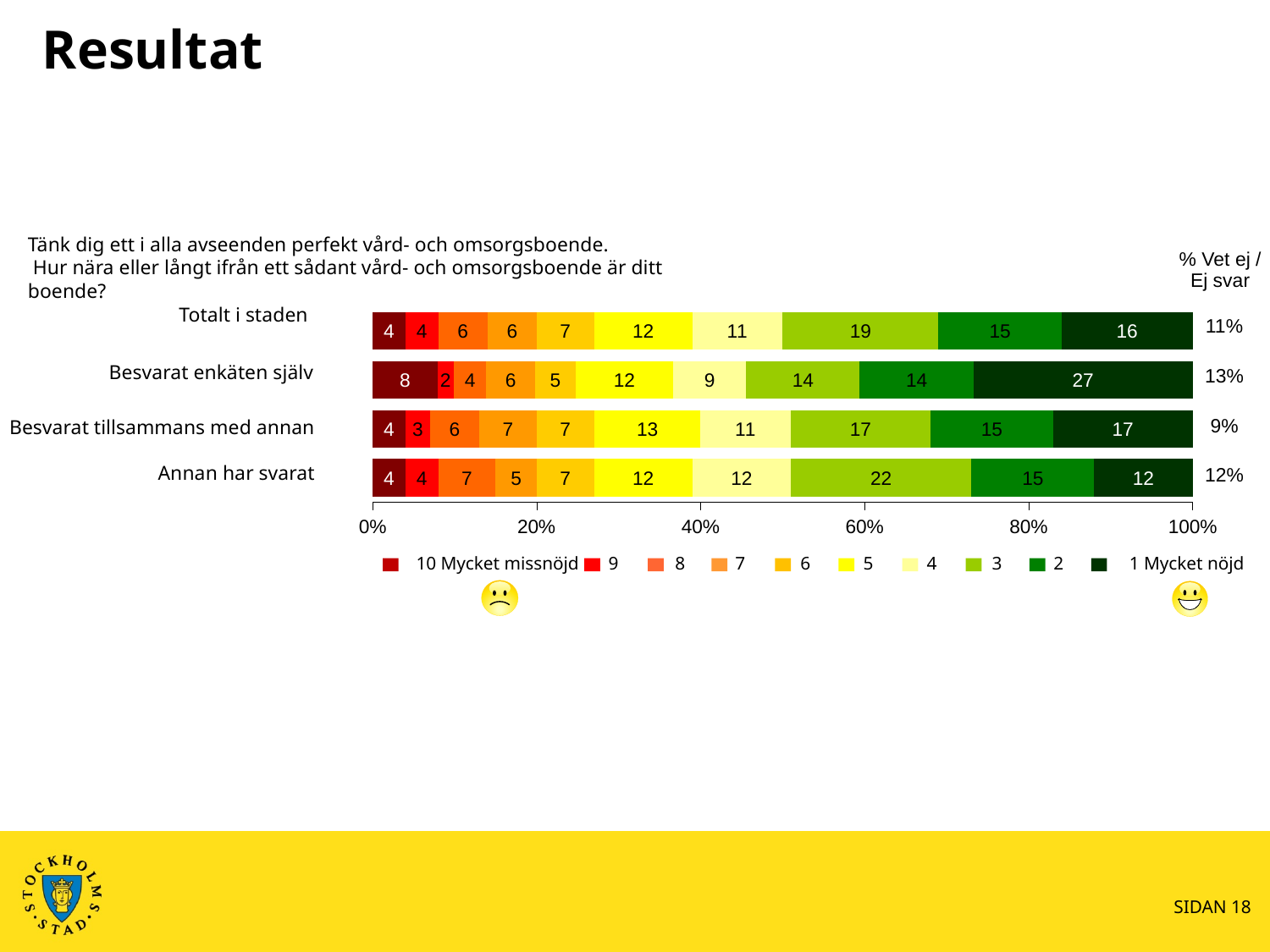
What is the first entry in the chart's legend? 10 Mycket missnöjd How many series does the legend list? 10 How many categories (rows) does the chart show? 4 What is the value of the '3' segment for 'Annan har svarat'? 22 What is the value of the '1 Mycket nöjd' segment for 'Besvarat enkäten själv'? 27 What is the difference between the '1 Mycket nöjd' values for 'Besvarat enkäten själv' and 'Annan har svarat'? 15 What kind of chart is shown on the slide? stacked bar chart What is the value of the '10 Mycket missnöjd' segment for 'Besvarat enkäten själv'? 8 Which is larger: the '3' segment for 'Totalt i staden' or for 'Besvarat tillsammans med annan'? Totalt i staden Which category has the smallest '9' segment? Besvarat enkäten själv Which category has the largest '1 Mycket nöjd' segment? Besvarat enkäten själv What is the '% Vet ej / Ej svar' value shown for 'Besvarat tillsammans med annan'? 9%